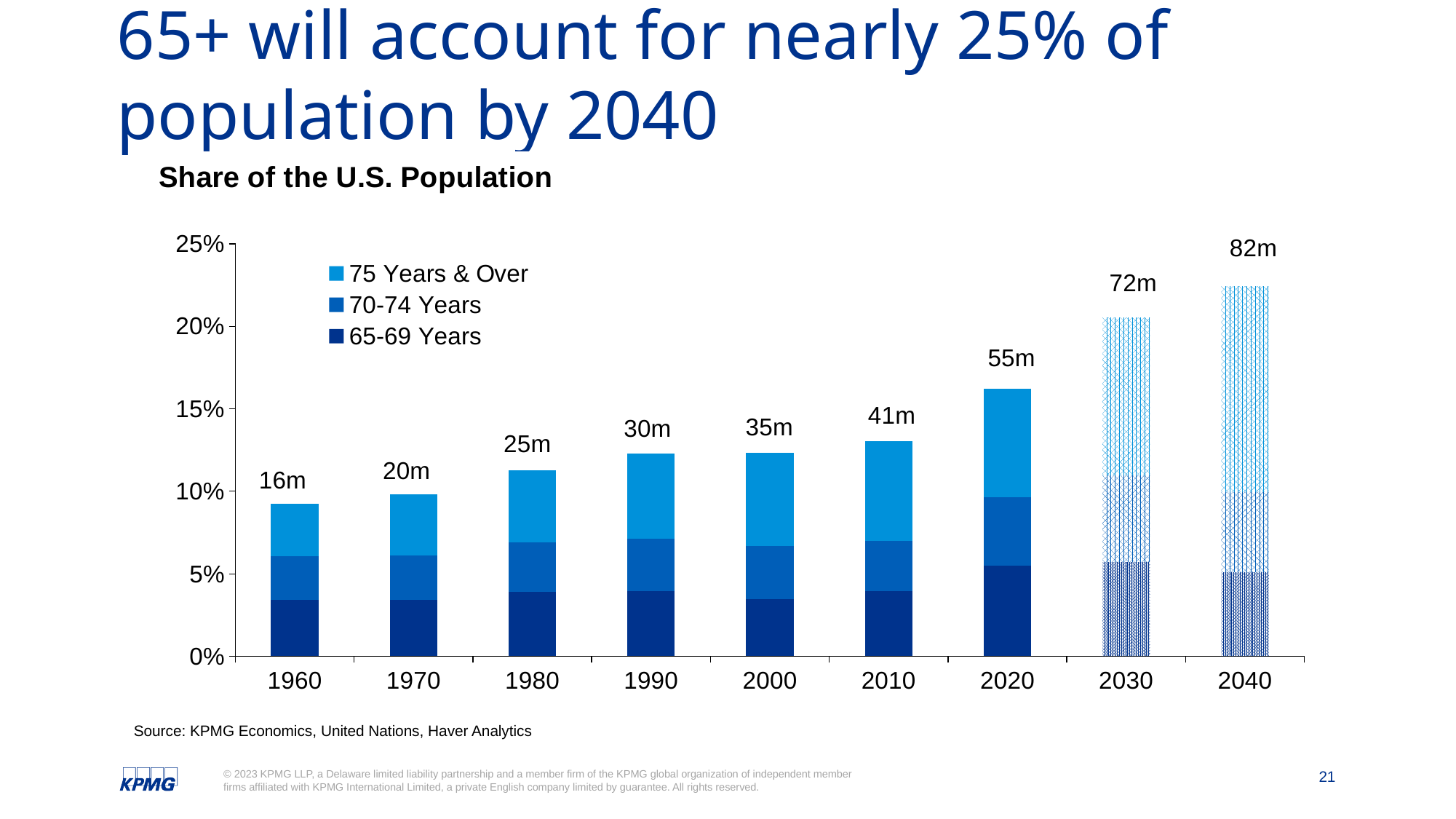
How many series does the legend list? 3 What is the data label shown above the 2040 bar? 82m Is the total share for 2040 greater or less than 20%? greater By how much does the labelled population for 2040 exceed that for 1960? 66m How many years are shown on the x axis? 9 Which year has the tallest stacked bar? 2040 Is the total share for 1960 greater or less than 10%? less What kind of chart is shown on the slide? Stacked bar chart Which year has the shortest stacked bar? 1960 What is the data label shown above the 1960 bar? 16m What is the data label shown above the 2020 bar? 55m Which stacked bar is taller, 2010 or 2020? 2020